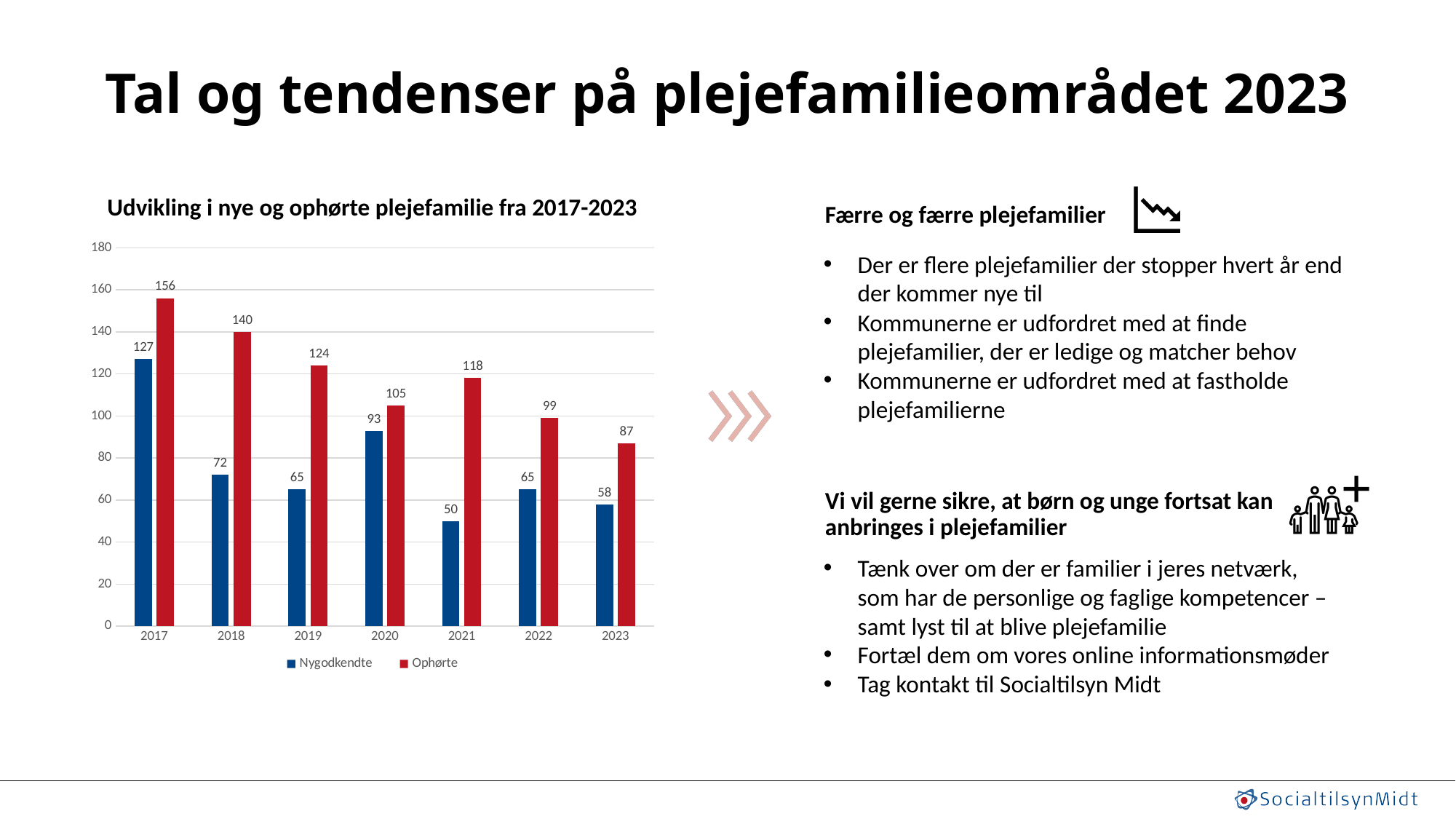
What is the value for Ophørte in 2021? 118 What is the value for Nygodkendte in 2023? 58 Which year has the lowest value for Nygodkendte? 2021 Which year has the highest value for Ophørte? 2017 What is the title of the chart? Udvikling i nye og ophørte plejefamilie fra 2017-2023 How many series does the legend list? 2 What kind of chart is shown on the slide? bar chart Is the value for Ophørte in 2019 greater or less than 100? greater Which is larger in 2020, Nygodkendte or Ophørte? Ophørte How many years are shown on the x axis? 7 What is the value for Nygodkendte in 2017? 127 What is the difference between Ophørte and Nygodkendte in 2018? 68